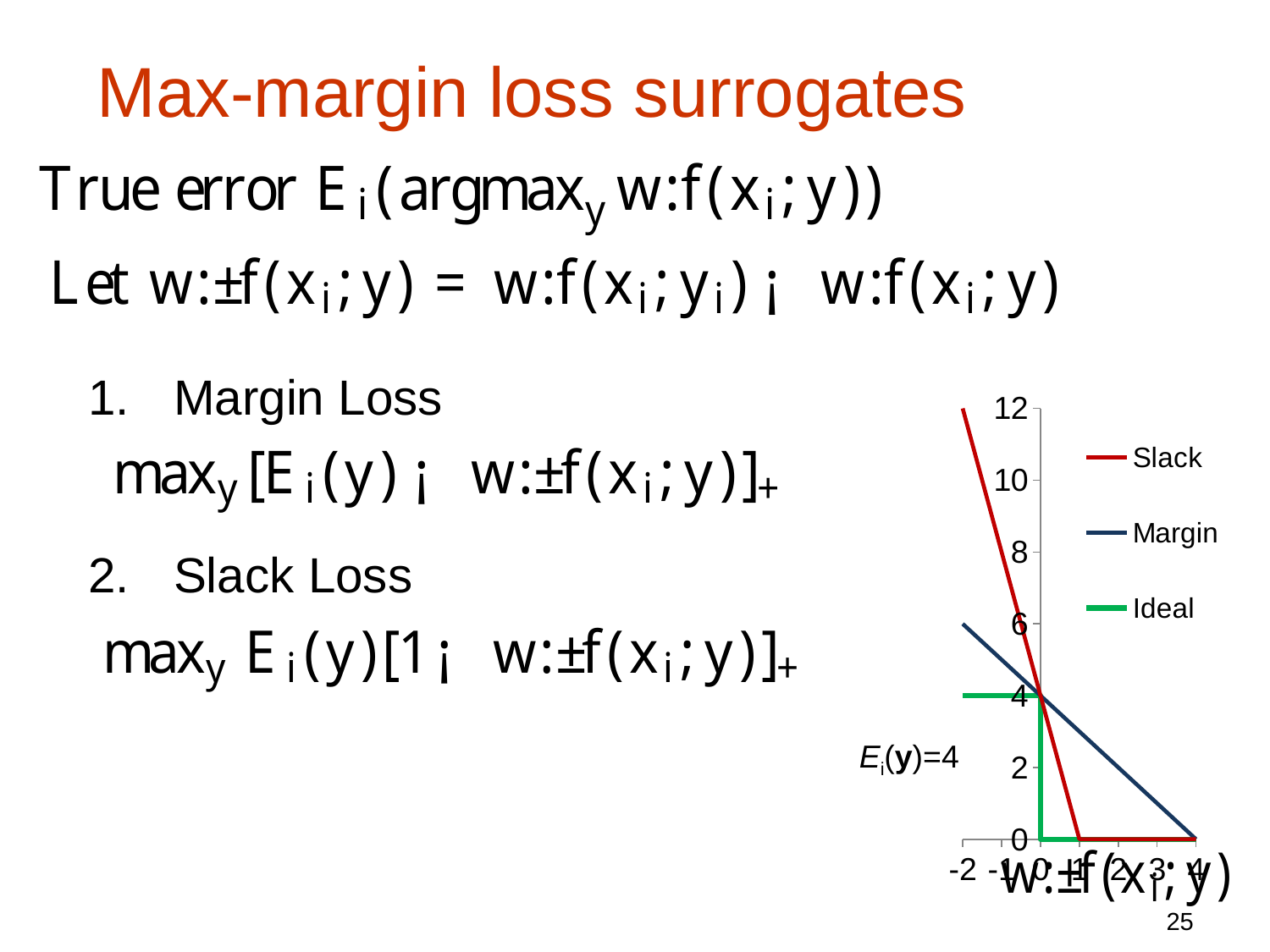
What is the highest value shown on the chart's y-axis? 12 Which series has the highest value at x = -2? Slack What are the three series named in the chart's legend? Slack, Margin, Ideal Does the Margin line rise or fall as the x-axis value increases? fall How many series does the chart's legend list? 3 What kind of chart is shown on the slide? line chart Does the Slack line rise or fall as the x-axis value increases? fall Is the value of the Slack line at x = -1 greater or less than 6? greater What colour is the Slack line in the chart? red Is the value of the Margin line at x = 2 greater or less than 4? less At x = -1, which line is higher, Slack or Margin? Slack According to the annotation on the chart, what is the value of E_i(y)? 4